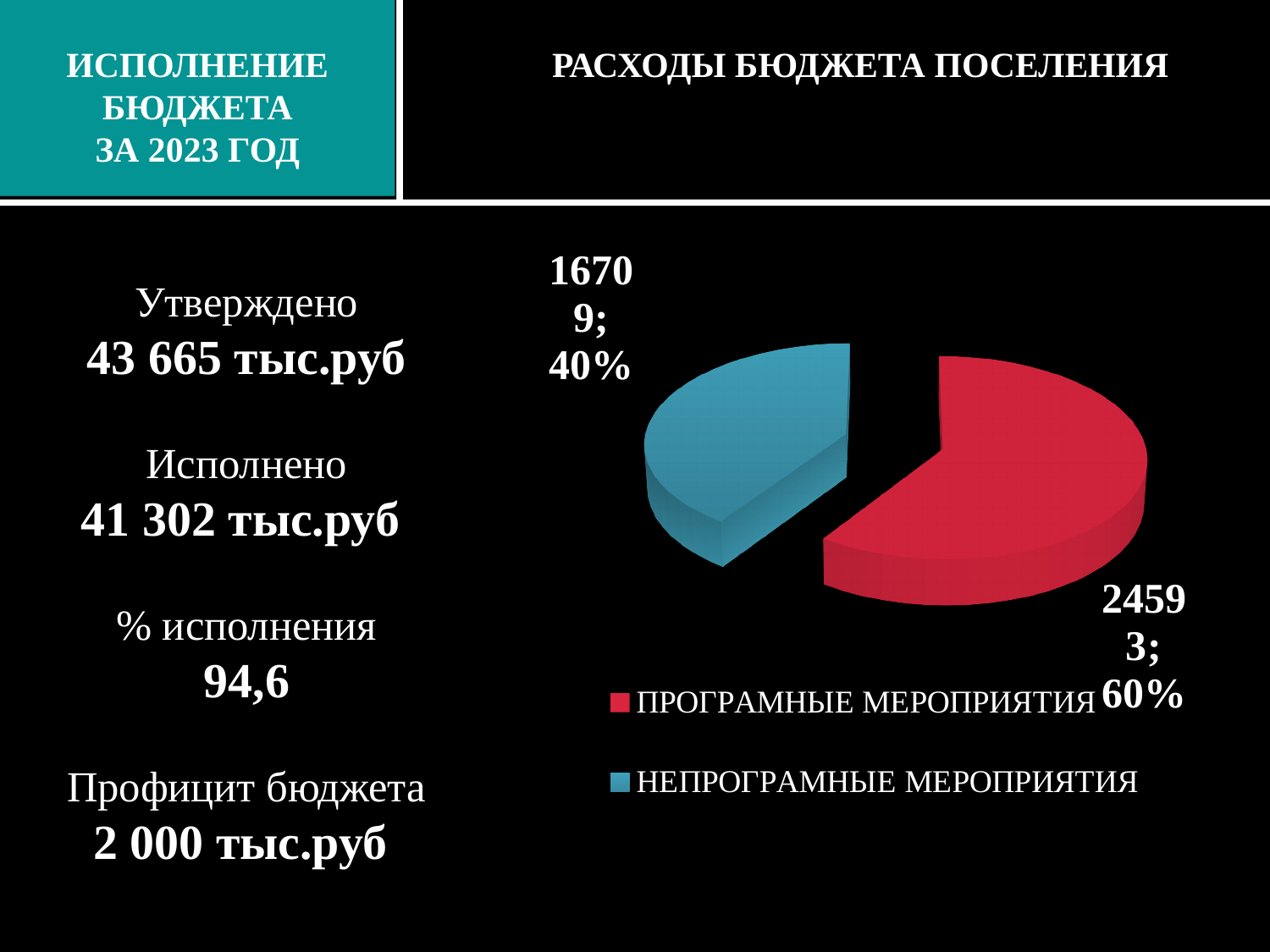
Which colour represents НЕПРОГРАМНЫЕ МЕРОПРИЯТИЯ in the pie chart? blue Which category has the smallest slice of the pie? НЕПРОГРАМНЫЕ МЕРОПРИЯТИЯ What value is shown for ПРОГРАМНЫЕ МЕРОПРИЯТИЯ? 24593 How many entries does the chart legend list? 2 What is the difference between the values for ПРОГРАМНЫЕ МЕРОПРИЯТИЯ and НЕПРОГРАМНЫЕ МЕРОПРИЯТИЯ? 7884 How many slices does the pie chart have? 2 What share of the pie does НЕПРОГРАМНЫЕ МЕРОПРИЯТИЯ take? 40% What kind of chart is shown on the slide? pie chart Which category has the largest slice of the pie? ПРОГРАМНЫЕ МЕРОПРИЯТИЯ What is the title of the chart? РАСХОДЫ БЮДЖЕТА ПОСЕЛЕНИЯ What value is shown for НЕПРОГРАМНЫЕ МЕРОПРИЯТИЯ? 16709 What share of the pie does ПРОГРАМНЫЕ МЕРОПРИЯТИЯ take? 60%